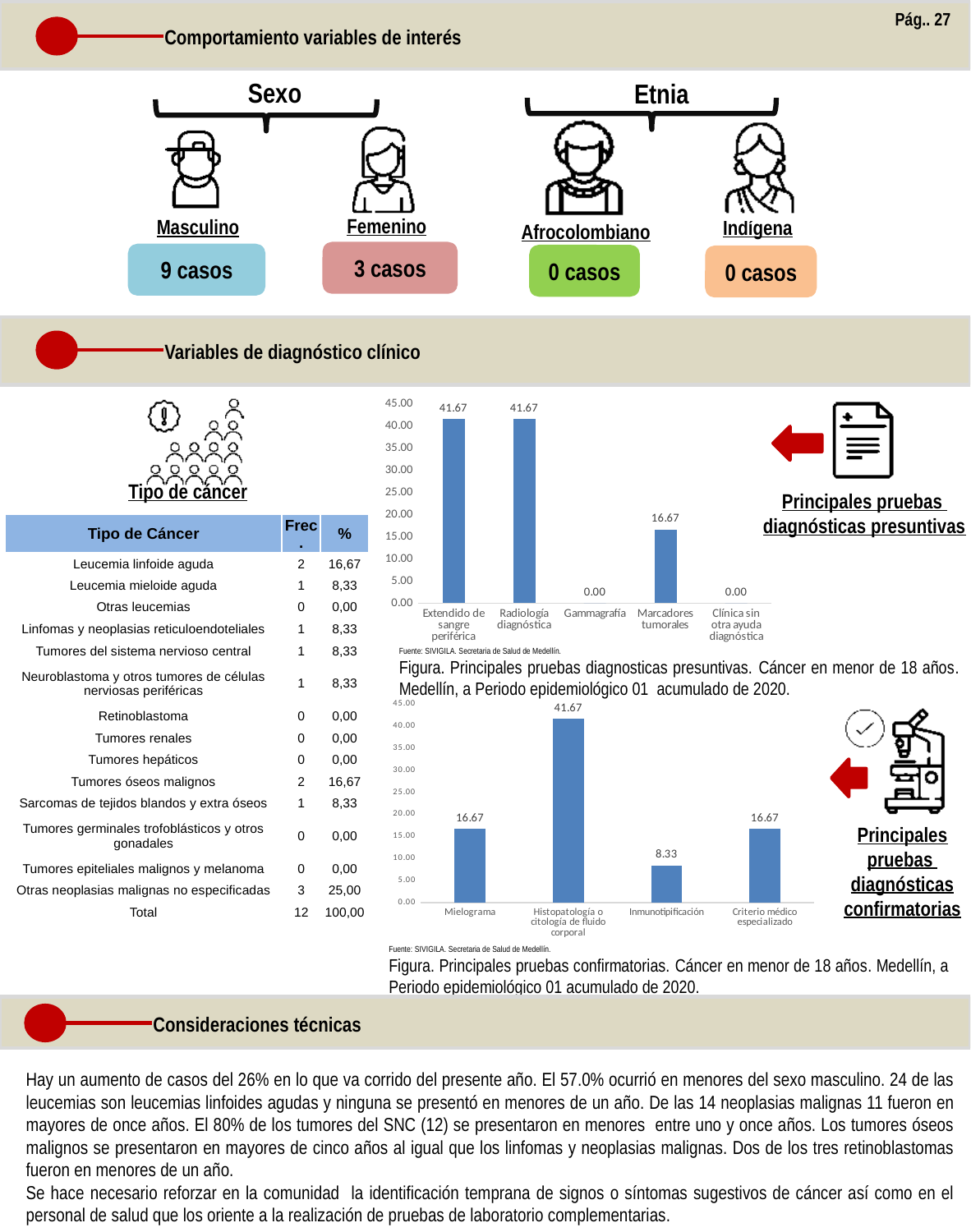
In the chart of principales pruebas diagnósticas presuntivas, how many categories are shown on the x axis? 5 In the chart of principales pruebas diagnósticas confirmatorias, how many categories are shown? 4 In the chart of principales pruebas diagnósticas presuntivas, is the value for Marcadores tumorales greater or less than 20.00? less What type of chart is used for principales pruebas diagnósticas confirmatorias? Bar chart In the chart of principales pruebas diagnósticas presuntivas, what is the value for Extendido de sangre periférica? 41.67 In the chart of principales pruebas diagnósticas presuntivas, what is the value for Marcadores tumorales? 16.67 In the chart of principales pruebas diagnósticas confirmatorias, which is larger: Mielograma or Inmunotipificación? Mielograma In the chart of principales pruebas diagnósticas confirmatorias, what is the value for Inmunotipificación? 8.33 In the chart of principales pruebas diagnósticas presuntivas, what is the difference between Radiología diagnóstica and Marcadores tumorales? 25.00 In the chart of principales pruebas diagnósticas confirmatorias, which category has the highest value? Histopatología o citología de fluido corporal In the chart of principales pruebas diagnósticas confirmatorias, which category has the lowest value? Inmunotipificación In the chart of principales pruebas diagnósticas presuntivas, what is the value for Gammagrafía? 0.00